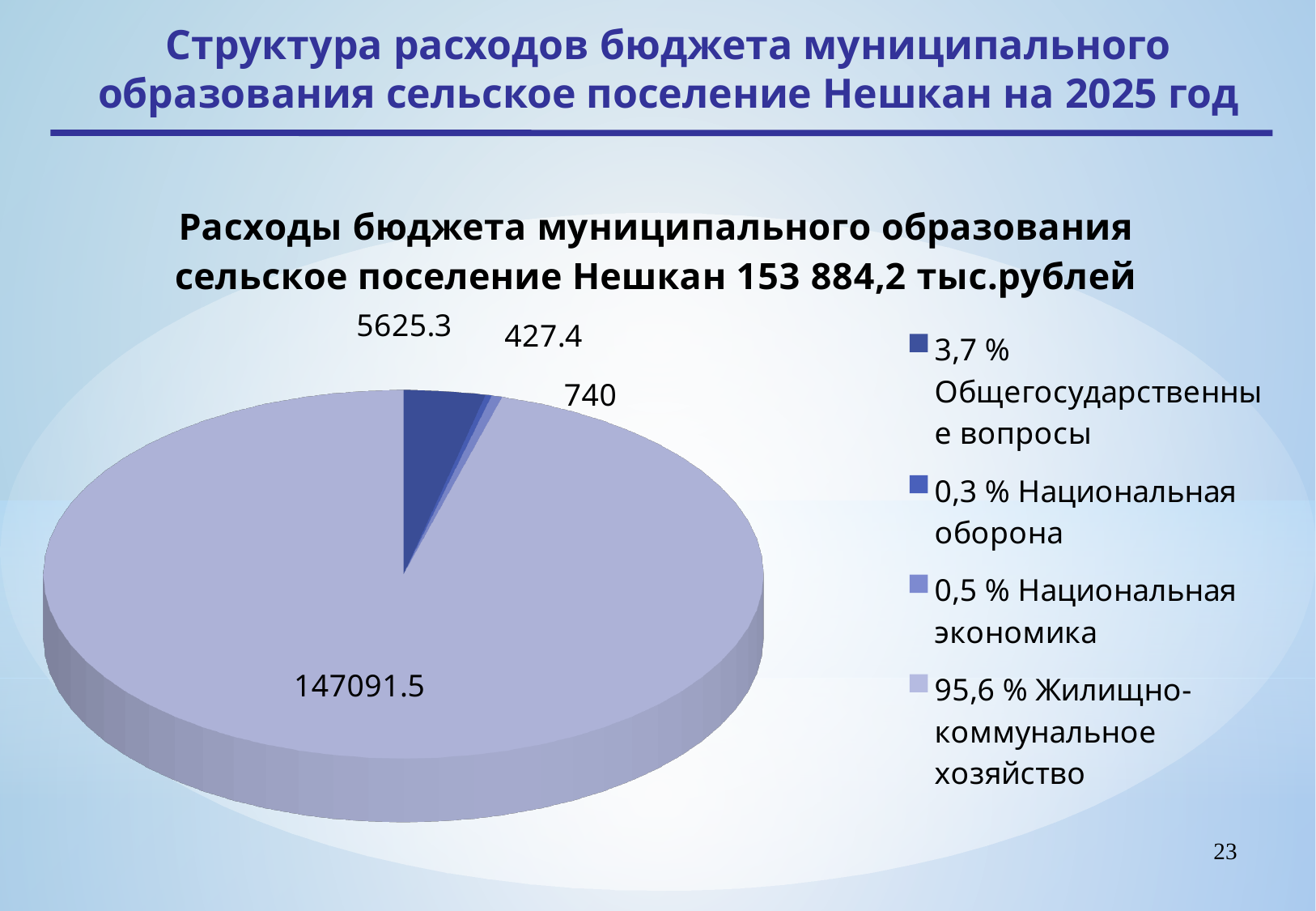
Which is larger: the value for Национальная экономика or the value for Национальная оборона? Национальная экономика How many slices does the pie chart have? 4 What is the value shown for Общегосударственные вопросы? 5625.3 How many entries does the legend of the pie chart list? 4 What share of the pie does Жилищно-коммунальное хозяйство represent, according to the legend? 95,6 % What is the value shown for Жилищно-коммунальное хозяйство? 147091.5 What is the difference between the values for Общегосударственные вопросы and Национальная экономика? 4885.3 What kind of chart is shown on the slide? pie chart What is the value shown for Национальная экономика? 740 What is the value shown for Национальная оборона? 427.4 Which category has the largest slice of the pie? Жилищно-коммунальное хозяйство Which category has the smallest slice of the pie? Национальная оборона